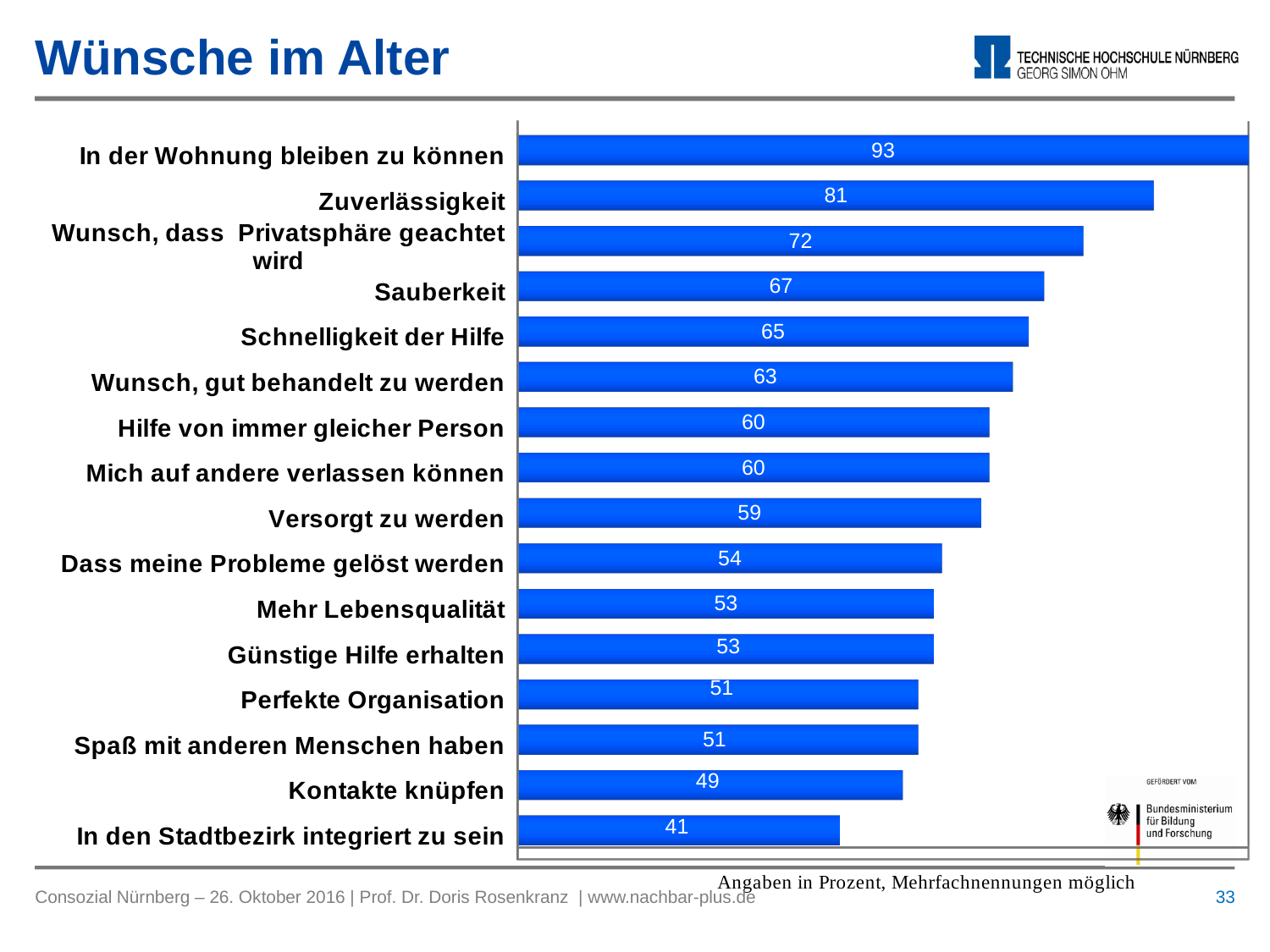
What is the value for "In der Wohnung bleiben zu können"? 93 What is the title of the slide? Wünsche im Alter What is the difference between the values for "Zuverlässigkeit" and "Schnelligkeit der Hilfe"? 16 Which category has the lowest value? In den Stadtbezirk integriert zu sein What kind of chart is shown on the slide? Bar chart What unit are the values given in, according to the note below the chart? Prozent What is the difference between the values for "In der Wohnung bleiben zu können" and "In den Stadtbezirk integriert zu sein"? 52 What is the value for "Kontakte knüpfen"? 49 What is the value for "Sauberkeit"? 67 Which category has the highest value? In der Wohnung bleiben zu können Which is larger: the value for "Versorgt zu werden" or the value for "Mehr Lebensqualität"? Versorgt zu werden How many categories are shown in the chart? 16